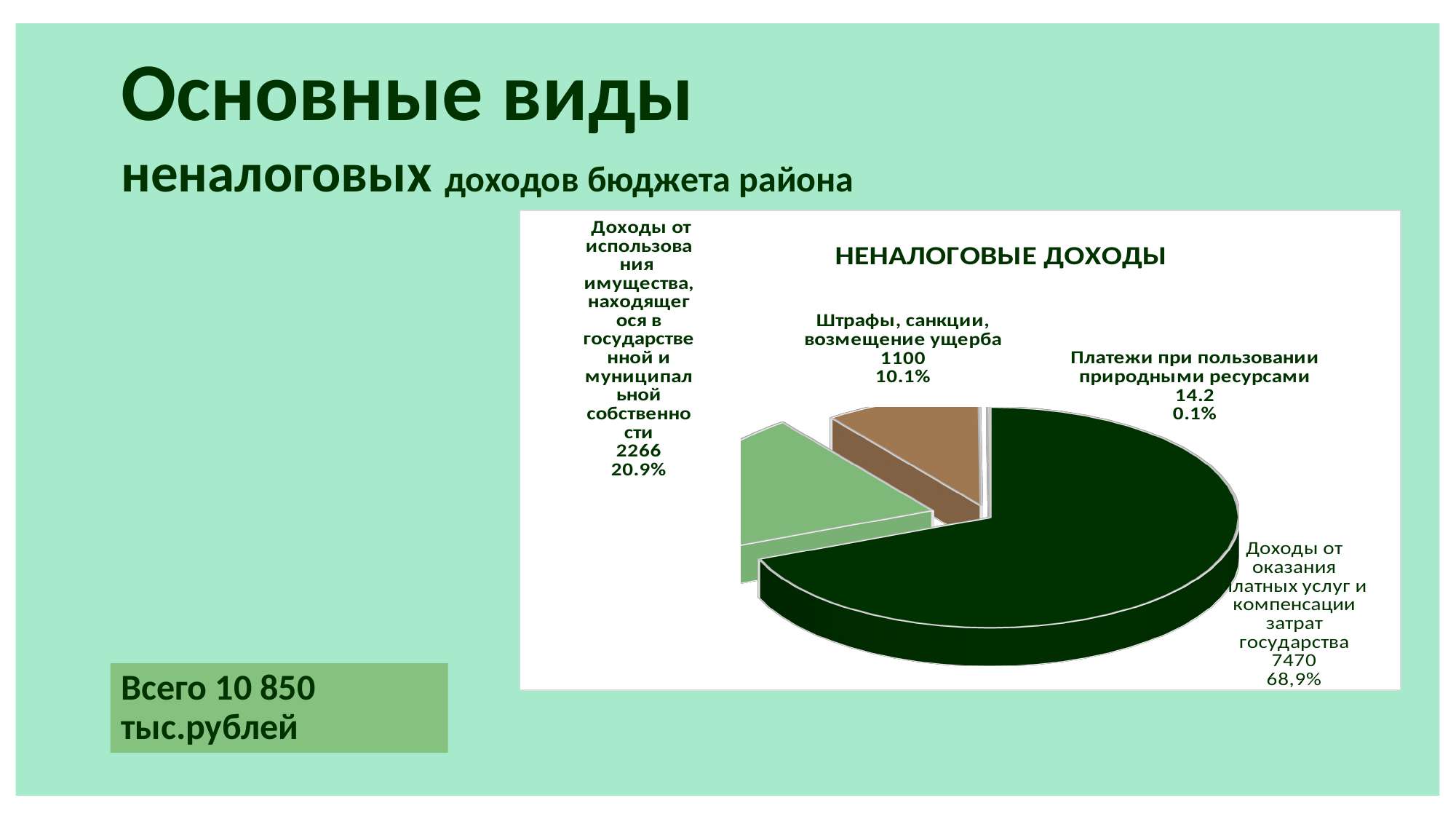
What is the value for Доходы от оказания платных услуг и компенсации затрат государства? 7470 Which category has the smallest slice? Платежи при пользовании природными ресурсами Which is larger: the value for Штрафы, санкции, возмещение ущерба or the value for Доходы от использования имущества? Доходы от использования имущества How many slices does the pie chart have? 4 Which category has the largest slice? Доходы от оказания платных услуг и компенсации затрат государства What is the title of the chart? НЕНАЛОГОВЫЕ ДОХОДЫ What share of the pie is Доходы от использования имущества, находящегося в государственной и муниципальной собственности? 20.9% What share of the pie is Доходы от оказания платных услуг и компенсации затрат государства? 68,9% What is the difference between the values for Доходы от использования имущества (2266) and Штрафы, санкции, возмещение ущерба (1100)? 1166 What is the value for Штрафы, санкции, возмещение ущерба? 1100 What kind of chart is shown on the slide? pie chart What is the value for Платежи при пользовании природными ресурсами? 14.2